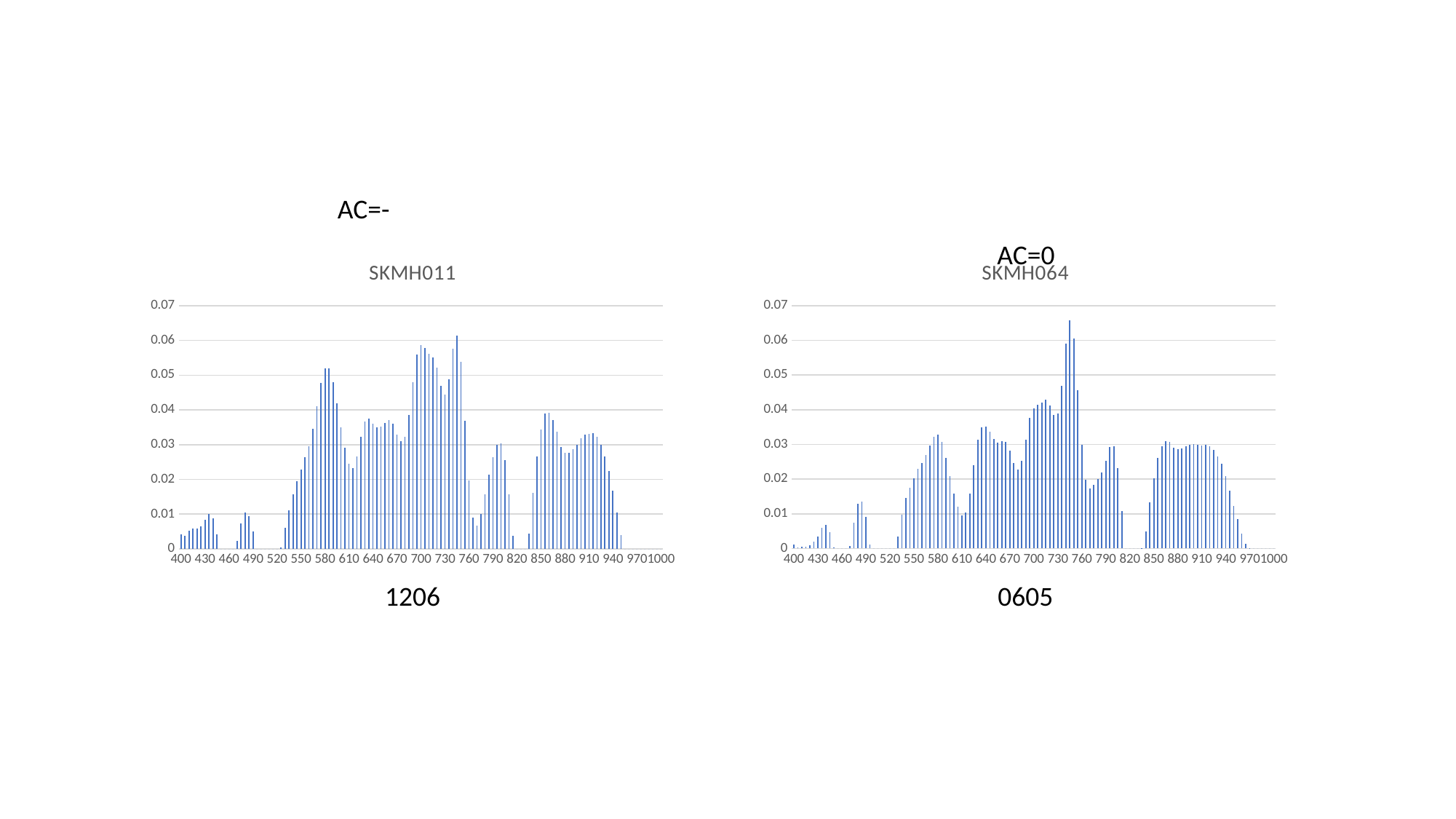
In the SKMH011 chart, is the value at 430 greater or less than 0.01? less What is the title of the chart on the left? SKMH011 What kind of chart is the SKMH064 chart? bar chart In the SKMH011 chart, is the value at 850 greater or less than 0.03? greater In the SKMH064 chart, is the value at 640 greater or less than 0.03? greater What is the title of the chart on the right? SKMH064 In the SKMH011 chart, which is larger, the value at 700 or the value at 850? 700 What kind of chart is the SKMH011 chart? bar chart How many charts are shown on the slide? 2